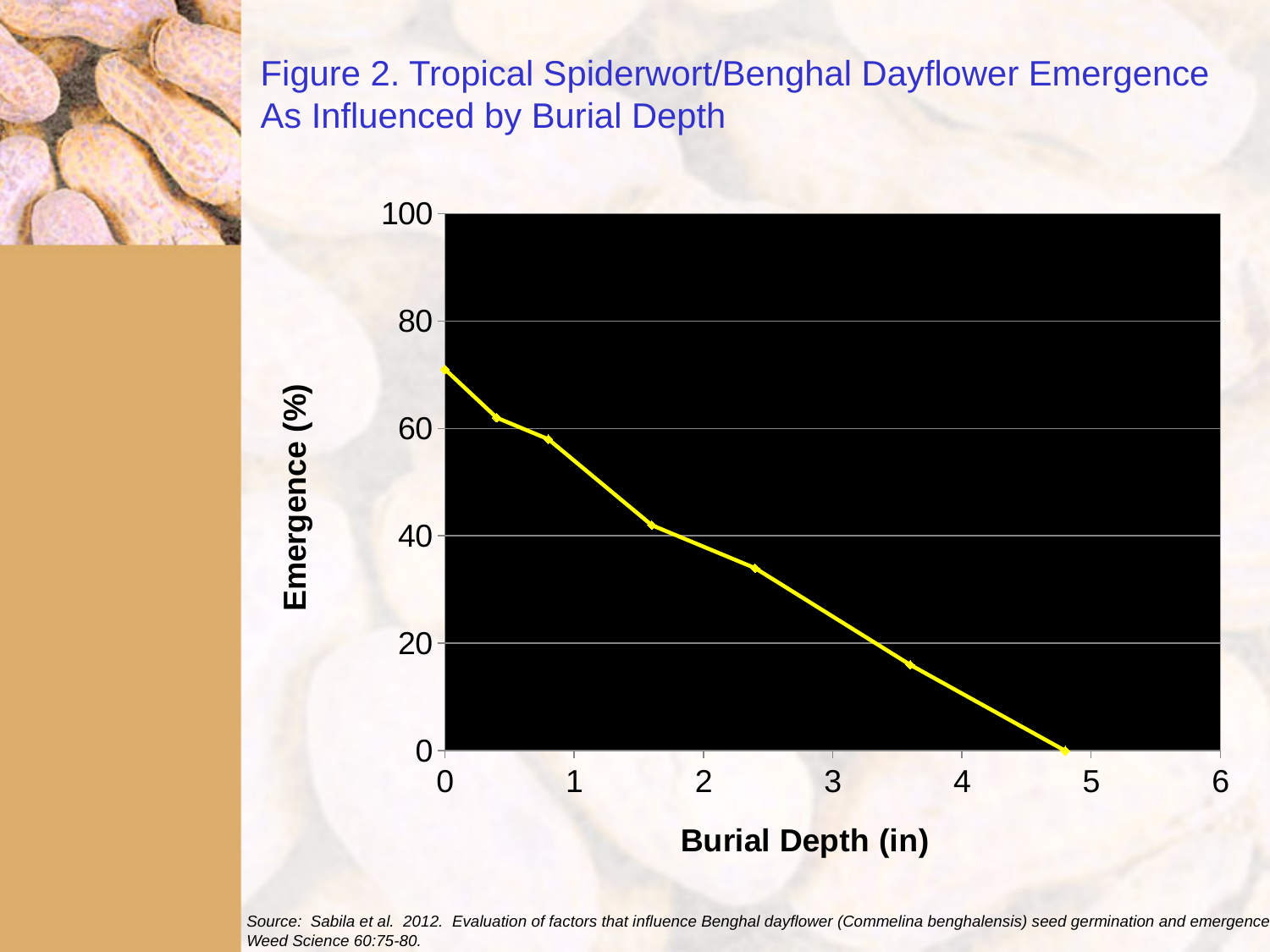
At which burial depth is emergence highest? 0 in Is the emergence value at a burial depth of 0 in greater or less than 80? less What is the emergence value at the last (deepest) point on the line? 0 As burial depth increases along the x axis, does emergence rise or fall? fall Is the emergence value at a burial depth of 0 in greater or less than 60? greater What kind of chart is shown on the slide? line chart What is the label of the y axis? Emergence (%) Is the emergence value for the point nearest a burial depth of 4 in greater or less than 20? less How many data points are plotted on the line? 7 What is the label of the x axis? Burial Depth (in) Which has higher emergence: the first point (0 in) or the last point on the line? the first point (0 in)